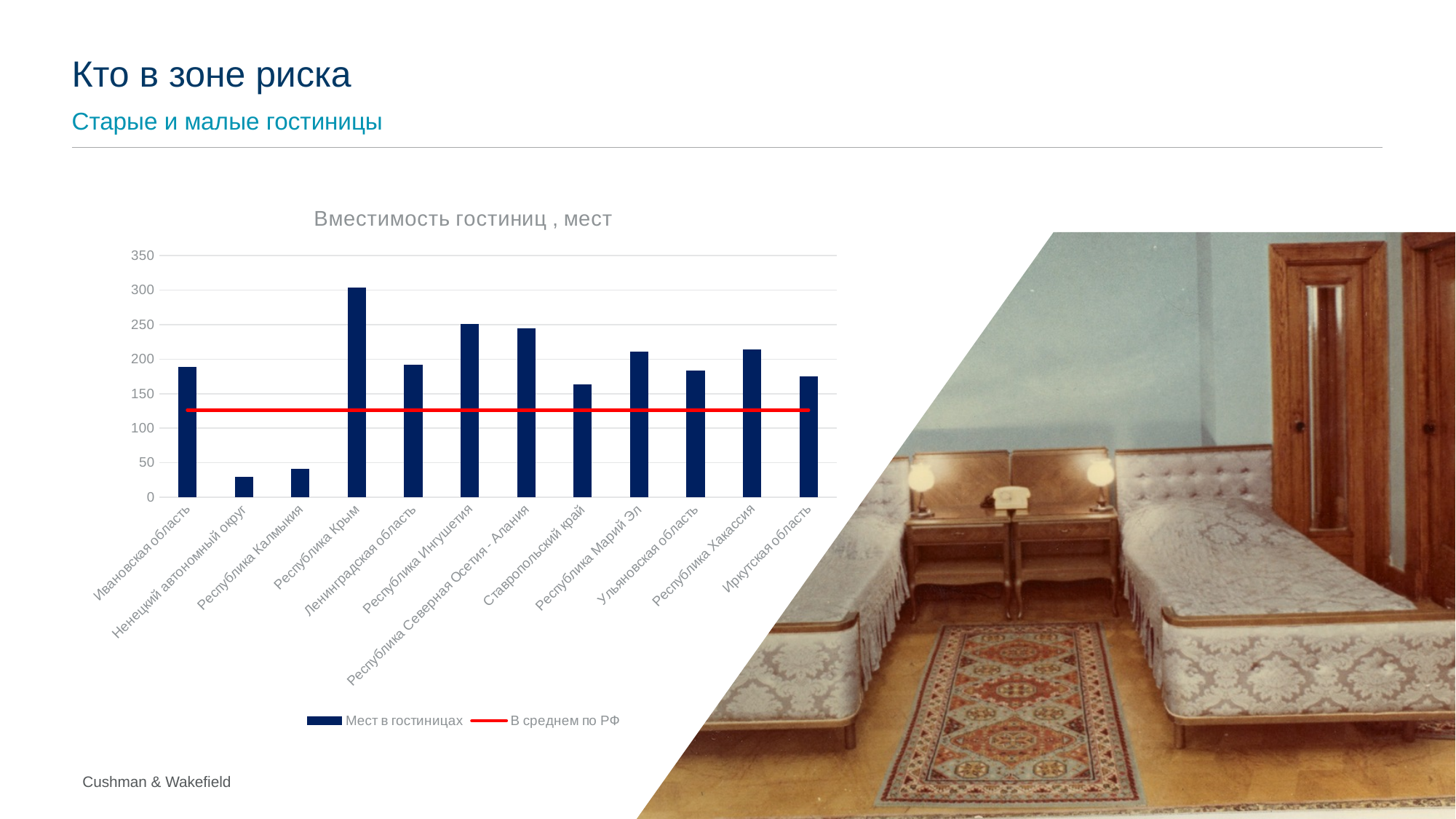
What kind of chart is shown on the slide? combination bar and line chart Which region has the highest value for Мест в гостиницах? Республика Крым How many entries does the chart legend list? 2 How many regions (categories) are plotted on the x axis of the chart? 12 Is the value for Республика Ингушетия greater or less than 200? greater Which region has the lowest value for Мест в гостиницах? Ненецкий автономный округ Is the value for Ставропольский край greater or less than 200? less Which is larger, the value for Республика Калмыкия or the value for Ивановская область? Ивановская область What is the title of the chart? Вместимость гостиниц , мест Is the value for Ненецкий автономный округ greater or less than 50? less What does the red horizontal line in the chart represent, according to the legend? В среднем по РФ